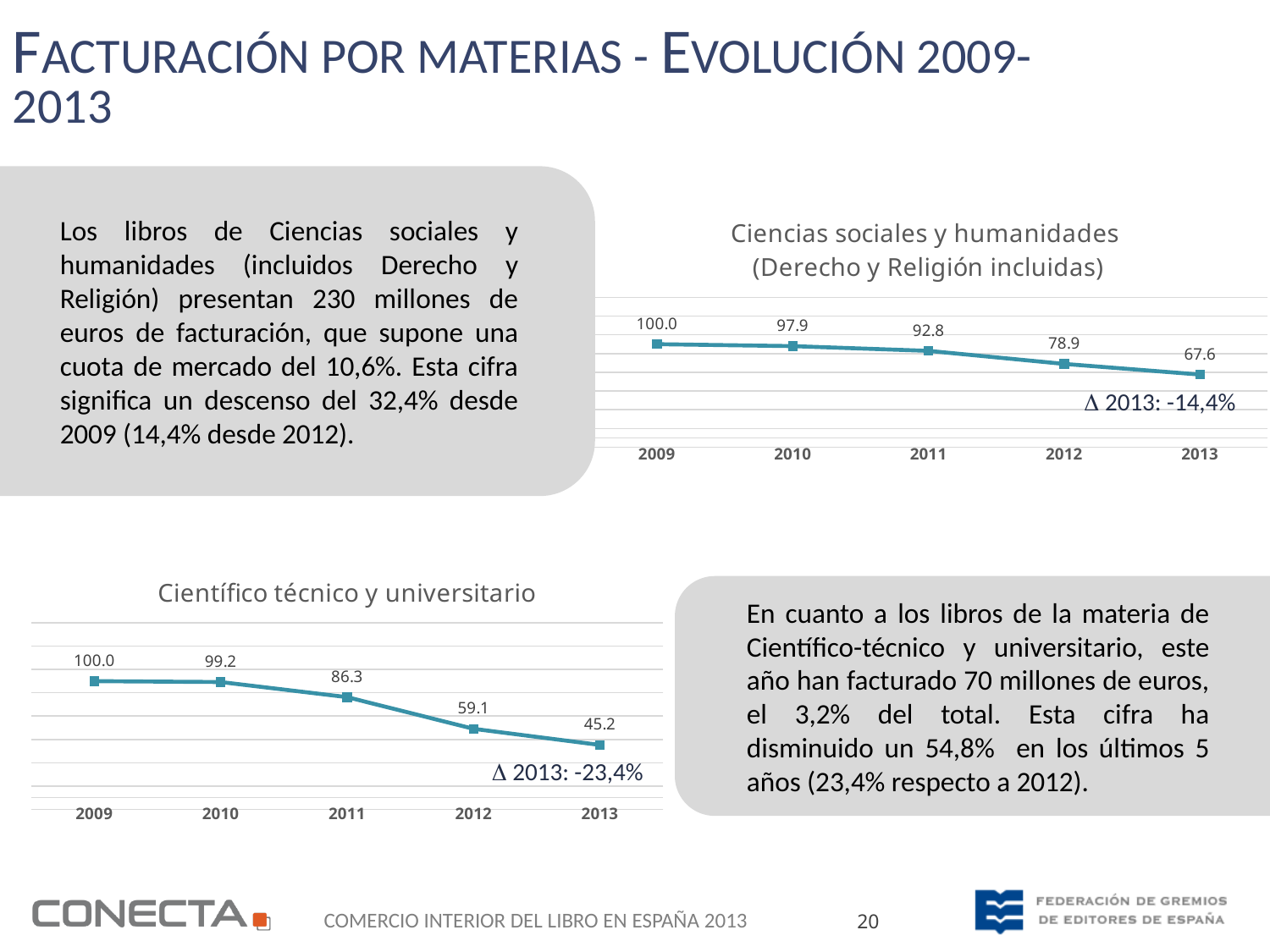
In the 'Ciencias sociales y humanidades (Derecho y Religión incluidas)' chart, what is the difference between the 2009 and 2013 values? 32.4 What type of chart is the 'Científico técnico y universitario' chart? line chart In the 'Científico técnico y universitario' chart, what is the value for 2011? 86.3 In the 'Ciencias sociales y humanidades (Derecho y Religión incluidas)' chart, what is the value for 2012? 78.9 Which is larger: the 2012 value in the 'Ciencias sociales y humanidades' chart or the 2012 value in the 'Científico técnico y universitario' chart? Ciencias sociales y humanidades (78.9) In the 'Científico técnico y universitario' chart, which year has the highest value? 2009 In the 'Científico técnico y universitario' chart, what is the value for 2013? 45.2 In the 'Científico técnico y universitario' chart, how many years are plotted? 5 In the 'Científico técnico y universitario' chart, what is the difference between the 2011 and 2012 values? 27.2 In the 'Ciencias sociales y humanidades (Derecho y Religión incluidas)' chart, which year has the lowest value? 2013 In the 'Ciencias sociales y humanidades (Derecho y Religión incluidas)' chart, do the values rise or fall from 2009 to 2013? fall In the 'Ciencias sociales y humanidades (Derecho y Religión incluidas)' chart, what is the value for 2013? 67.6